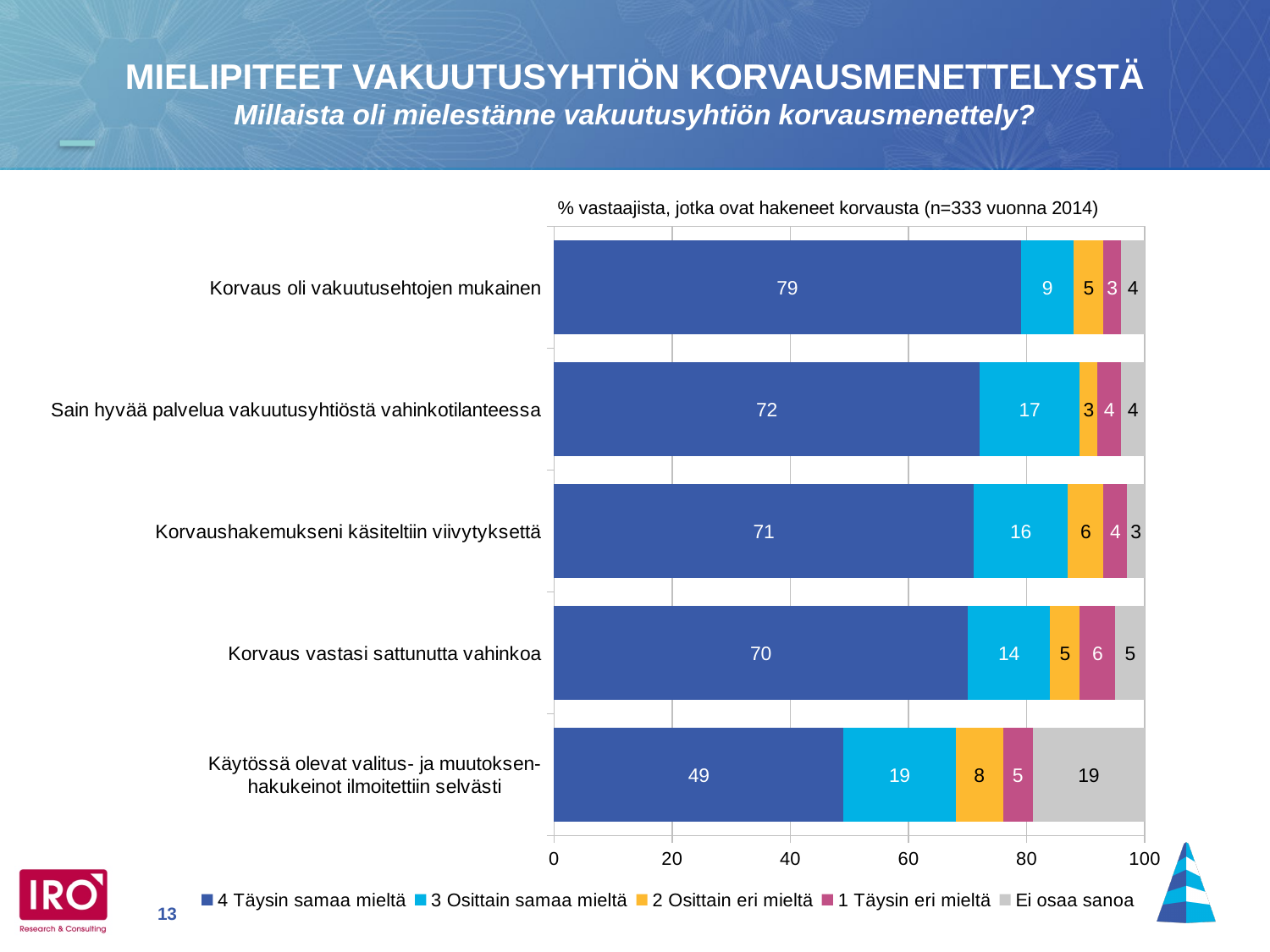
How many series does the legend list? 5 What type of chart is shown on the slide? Stacked bar chart What is the value of '4 Täysin samaa mieltä' for 'Korvaus oli vakuutusehtojen mukainen'? 79 What is the total of the stacked bar for 'Korvaushakemukseni käsiteltiin viivytyksettä'? 100 What is the subtitle text shown above the chart? % vastaajista, jotka ovat hakeneet korvausta (n=333 vuonna 2014) Which statement has the highest value for '4 Täysin samaa mieltä'? Korvaus oli vakuutusehtojen mukainen What is the value of '3 Osittain samaa mieltä' for 'Käytössä olevat valitus- ja muutoksenhakukeinot ilmoitettiin selvästi'? 19 How many statements (categories) are plotted in the chart? 5 Which is larger: the '3 Osittain samaa mieltä' value for 'Sain hyvää palvelua vakuutusyhtiöstä vahinkotilanteessa' or for 'Korvaus vastasi sattunutta vahinkoa'? Sain hyvää palvelua vakuutusyhtiöstä vahinkotilanteessa Which statement has the lowest value for '4 Täysin samaa mieltä'? Käytössä olevat valitus- ja muutoksenhakukeinot ilmoitettiin selvästi What is the value of 'Ei osaa sanoa' for 'Korvaus vastasi sattunutta vahinkoa'? 5 What is the difference between the '4 Täysin samaa mieltä' values for 'Korvaus oli vakuutusehtojen mukainen' and 'Käytössä olevat valitus- ja muutoksenhakukeinot ilmoitettiin selvästi'? 30